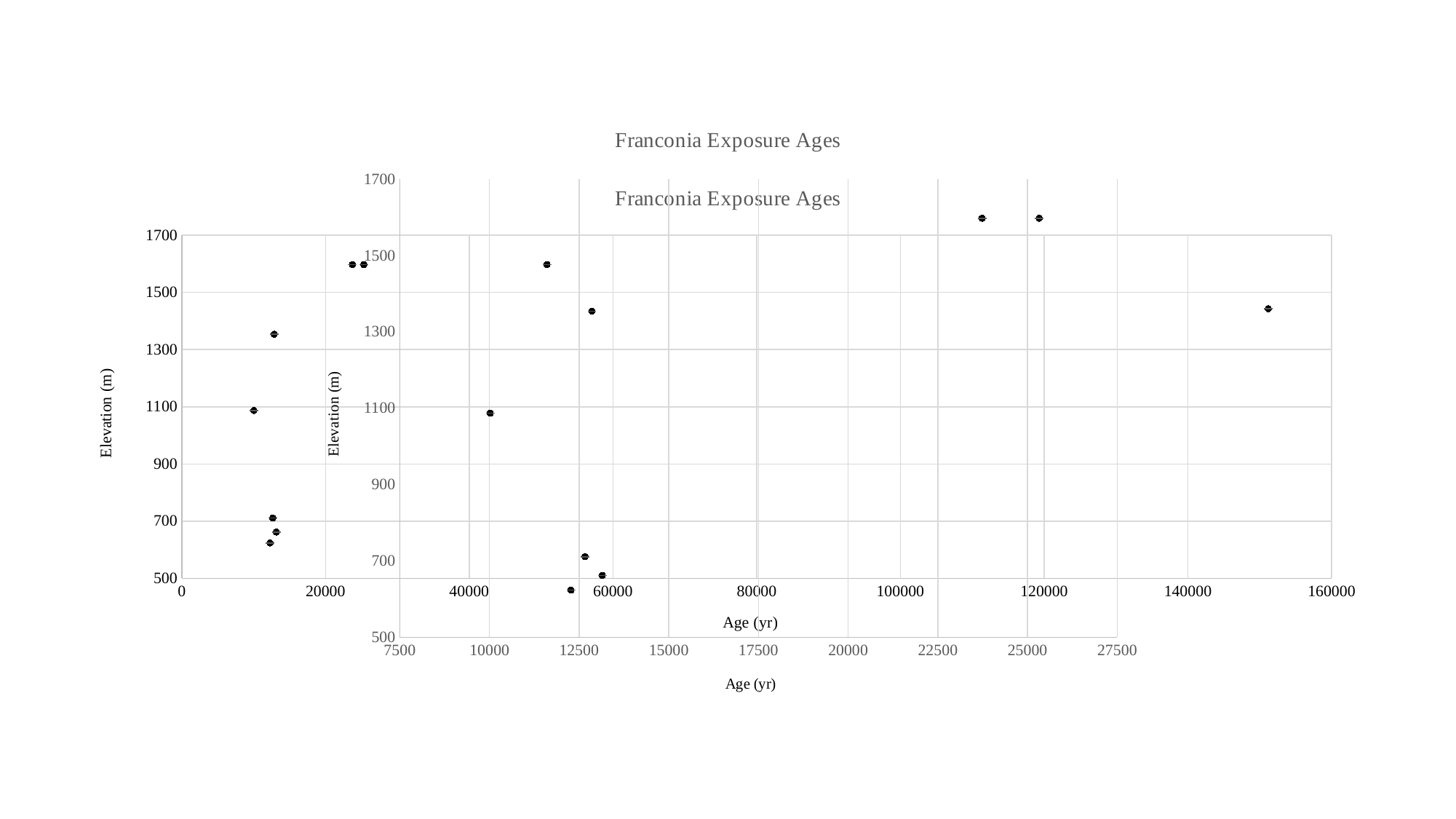
In the smaller chart (x axis 7500 to 27500), is the elevation of the lowest point greater or less than 700? less In the smaller chart (x axis 7500 to 27500), is the age of the rightmost point greater or less than 25000? greater In the larger chart (x axis 0 to 160000), is the elevation of the rightmost point greater or less than 1300? greater What is the title of the charts on the slide? Franconia Exposure Ages What is the label of the x axis on the charts? Age (yr) What kind of chart is shown on the slide? Scatter chart